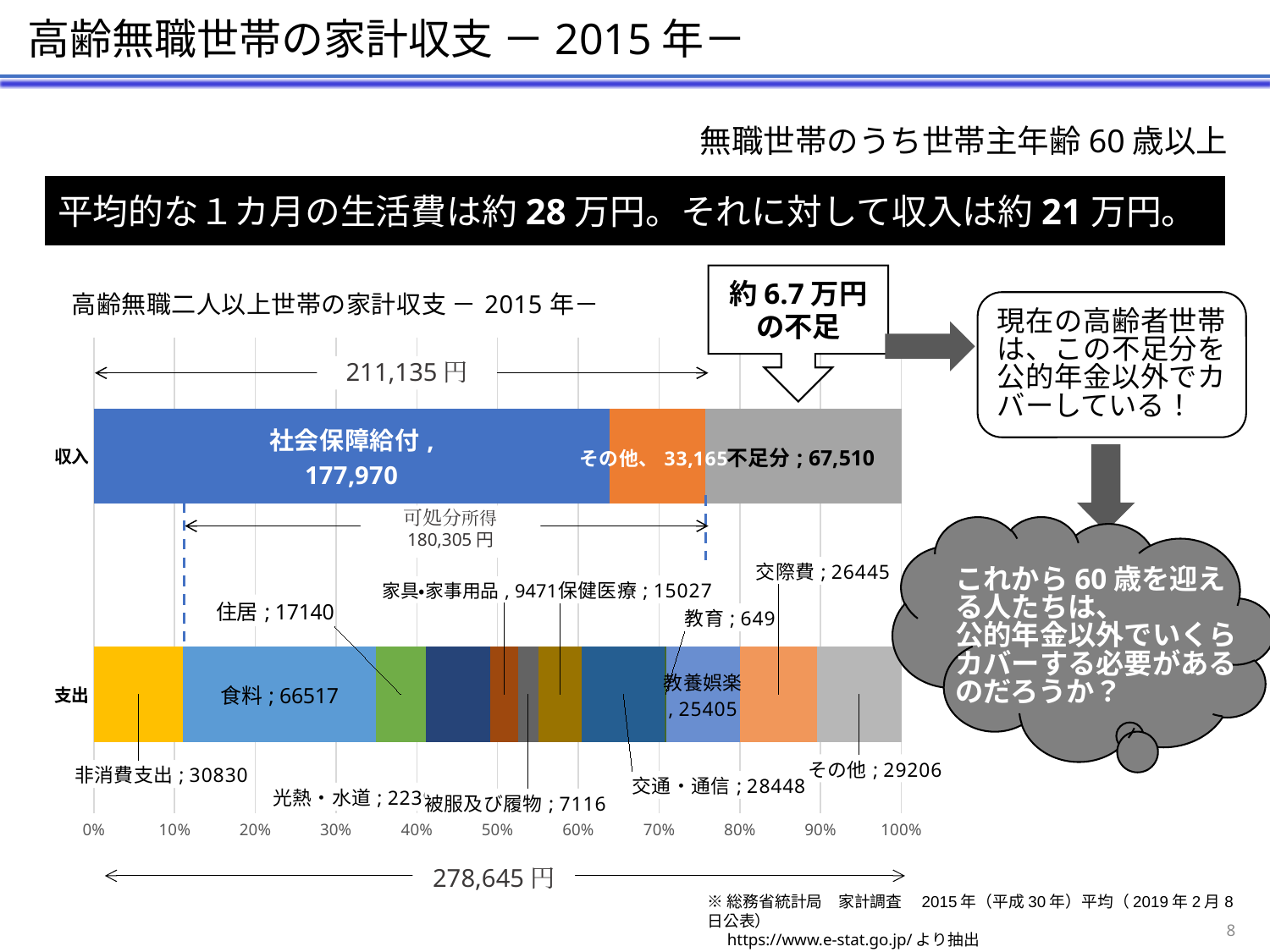
Which segment of the 支出 bar has the largest value? 食料 What is the difference between 社会保障給付 and その他 in the 収入 bar? 144,805 What is the value of 社会保障給付 in the 収入 bar? 177,970 What is the value of 不足分 in the 収入 bar? 67,510 What kind of chart is shown on the slide? Stacked bar chart How many bars (categories) does the chart have? 2 What is the title of the chart? 高齢無職二人以上世帯の家計収支 － 2015 年－ What is the value of 食料 in the 支出 bar? 66517 What is the total amount shown for the 支出 bar? 278,645 円 Which segment of the 支出 bar has the smallest value? 教育 Which is larger in the 支出 bar, 交際費 or 教養娯楽? 交際費 What is the value of 交通・通信 in the 支出 bar? 28448